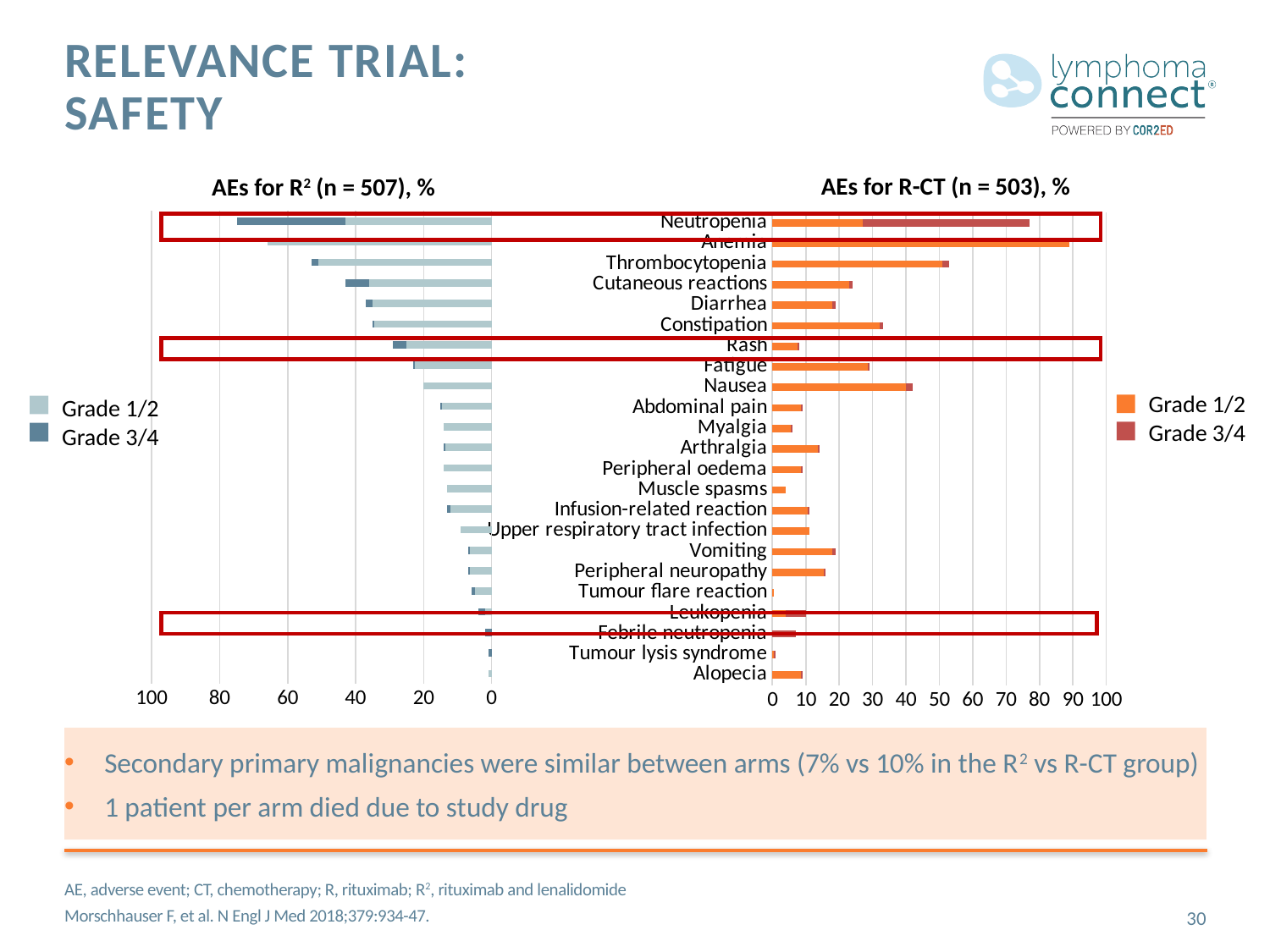
What are the two legend entries shown for the AEs for R-CT (n = 503), % chart? Grade 1/2 and Grade 3/4 How many adverse event categories are listed on the charts? 23 What kind of chart is used for the AEs for R-CT (n = 503), % data? Bar chart How many series does the legend for the AEs for R² (n = 507), % chart list? 2 In the AEs for R-CT (n = 503), % chart, is the total value for Anemia greater or less than 80? greater In the AEs for R-CT (n = 503), % chart, which adverse event has the longest bar? Anemia In the AEs for R² (n = 507), % chart, is the total value for Anemia greater or less than 60? greater In the AEs for R-CT (n = 503), % chart, is the total value for Neutropenia greater or less than 70? greater Is the total bar for Nausea longer in the AEs for R² (n = 507), % chart or in the AEs for R-CT (n = 503), % chart? AEs for R-CT (n = 503), % Is the total bar for Rash longer in the AEs for R² (n = 507), % chart or in the AEs for R-CT (n = 503), % chart? AEs for R² (n = 507), % In the AEs for R² (n = 507), % chart, which adverse event has the longest bar? Neutropenia